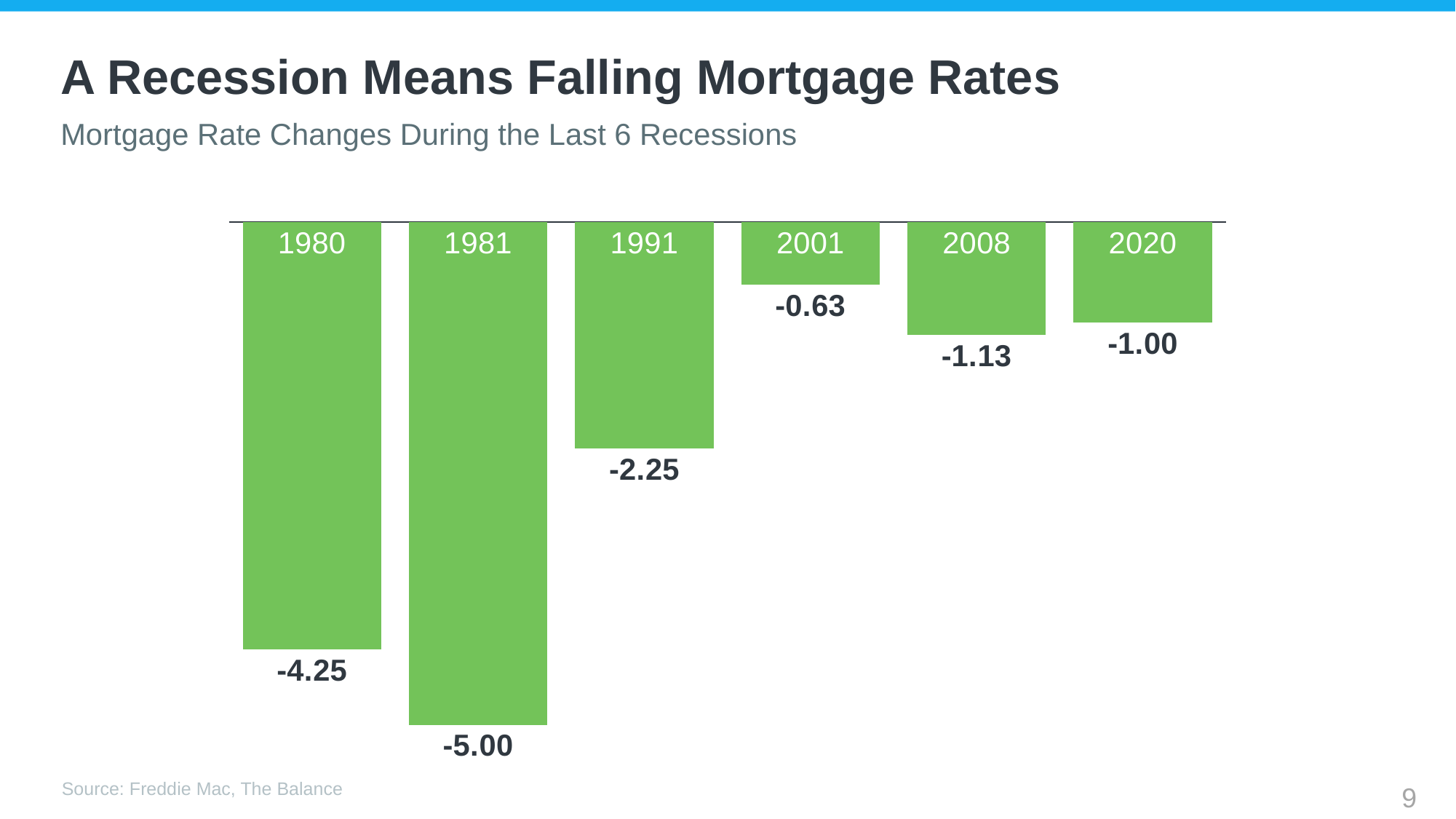
Which year shows a larger drop in mortgage rates, 2008 or 2020? 2008 How many recessions are shown in the chart? 6 What is the mortgage rate change shown for 2008? -1.13 What is the mortgage rate change shown for 2020? -1.00 What is the mortgage rate change shown for 2001? -0.63 What kind of chart is shown on the slide? Bar chart Which recession year shows the smallest drop in mortgage rates? 2001 Which recession year shows the largest drop in mortgage rates? 1981 What is the difference between the mortgage rate changes for 1991 and 2008? 1.12 What is the difference between the mortgage rate changes for 1981 and 1980? 0.75 What is the mortgage rate change shown for 1980? -4.25 What is the source cited for the chart? Freddie Mac, The Balance